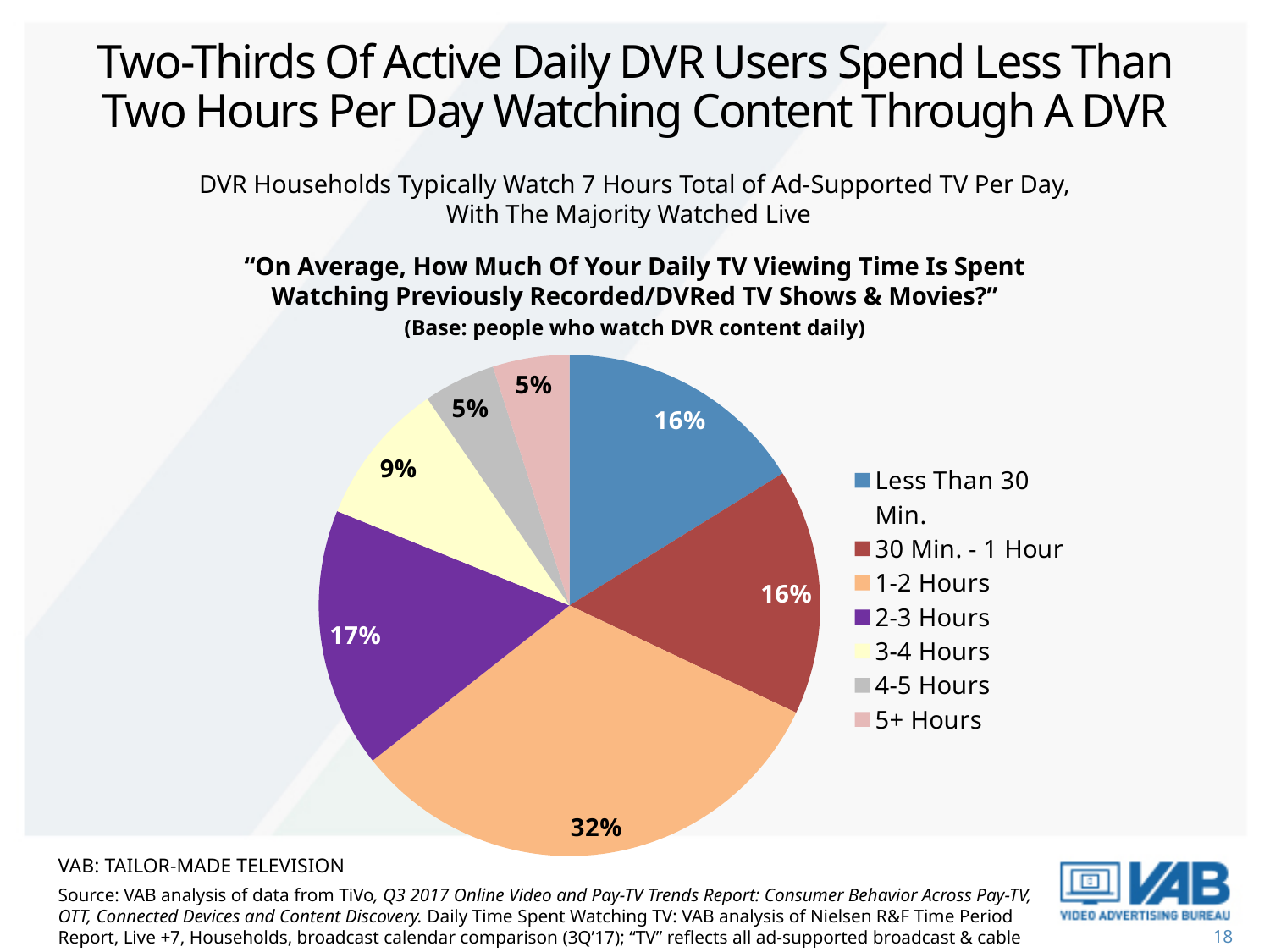
Which slice is larger: 1-2 Hours or 3-4 Hours? 1-2 Hours What kind of chart is shown on the slide? Pie chart What percentage of daily DVR viewers spend 5+ hours watching DVRed content? 5% What percentage of daily DVR viewers spend 3-4 hours watching DVRed content? 9% How many categories does the pie chart show? 7 Which viewing-time category has the largest share of the pie? 1-2 Hours What is the combined share of viewers who spend less than 2 hours per day (Less Than 30 Min., 30 Min. - 1 Hour, and 1-2 Hours)? 64% What colour is the 2-3 Hours slice in the pie chart? Purple What percentage of daily DVR viewers spend less than 30 minutes watching DVRed content? 16% What percentage of daily DVR viewers spend 1-2 hours watching previously recorded content? 32% What is the difference in percentage points between the 1-2 Hours slice and the 2-3 Hours slice? 15 percentage points What percentage of daily DVR viewers spend 2-3 hours watching DVRed content? 17%